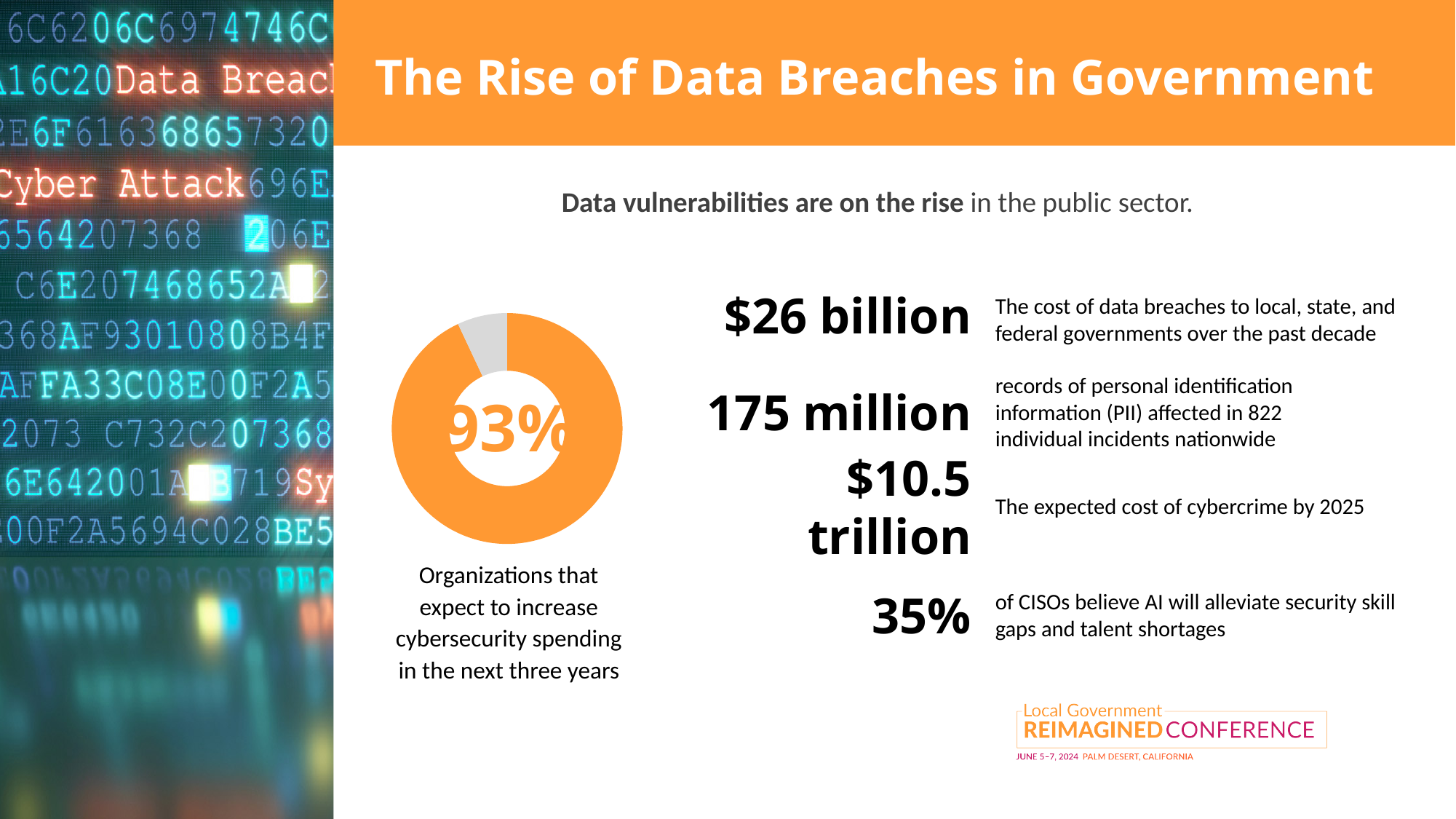
What colour is the largest slice of the donut chart? Orange What does the donut chart represent, according to its caption? Organizations that expect to increase cybersecurity spending in the next three years How many slices does the donut chart have? 2 Is the value shown in the donut chart greater or less than 90%? greater What share of organizations expect to increase cybersecurity spending in the next three years, according to the donut chart? 93% What percentage is shown in the centre of the donut chart? 93% Which slice of the donut chart is larger, the orange one or the grey one? The orange one What share of the donut chart is represented by the grey slice? 7% What kind of chart is shown on the slide? Donut (pie) chart Is the value shown in the donut chart greater or less than 50%? greater